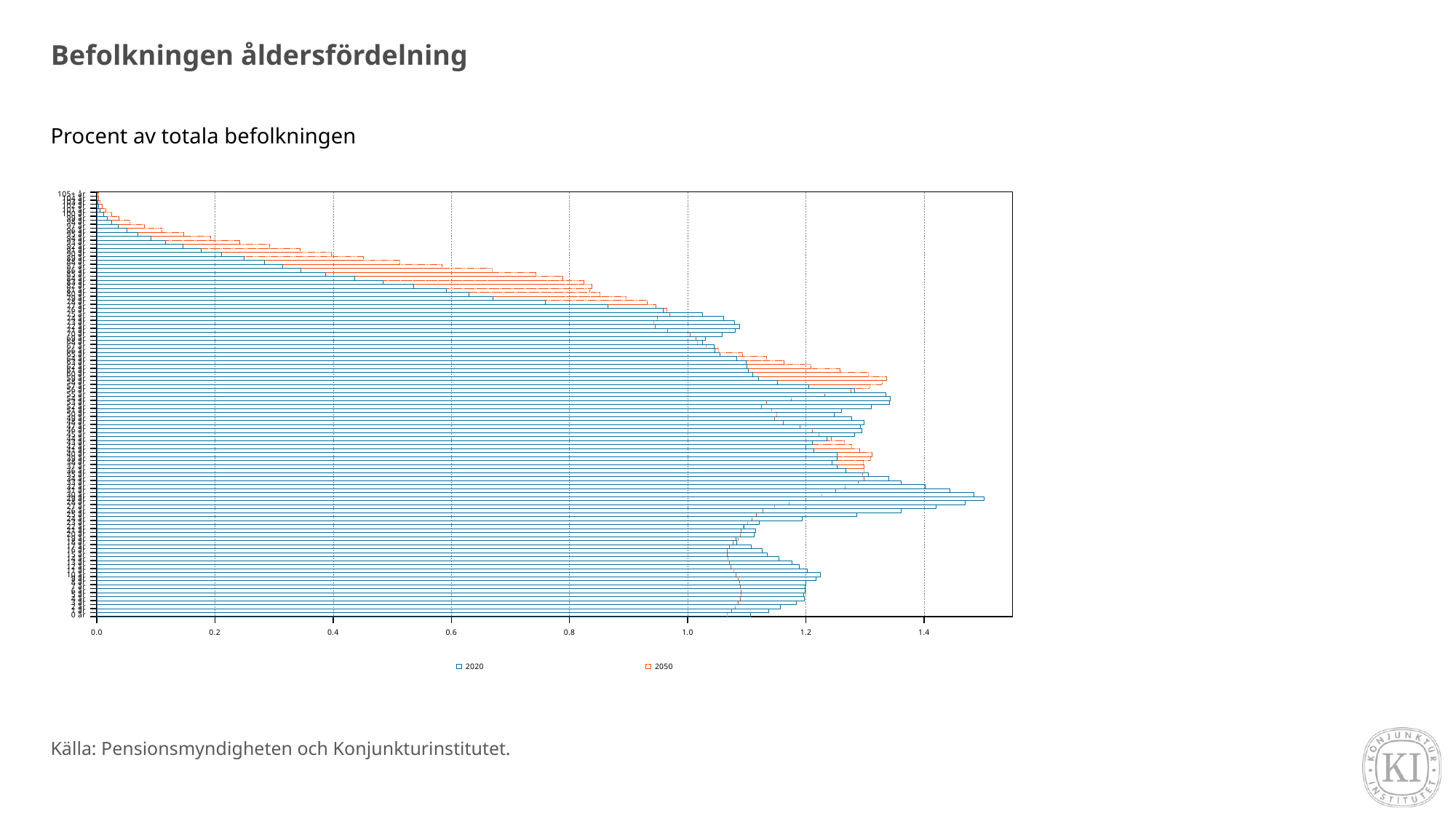
Is the 2020 value for age 105+ greater or less than 0.2? less Is the highest 2020 value on the chart greater or less than 1.4? greater What kind of chart is shown on the slide? Bar chart Is the 2050 value for age 105+ greater or less than 0.2? less How many series does the legend list? 2 What are the two series named in the legend? 2020 and 2050 For age 0, which series has the larger value, 2020 or 2050? 2020 What is the title of the slide? Befolkningen åldersfördelning Which series reaches the highest value anywhere on the chart? 2020